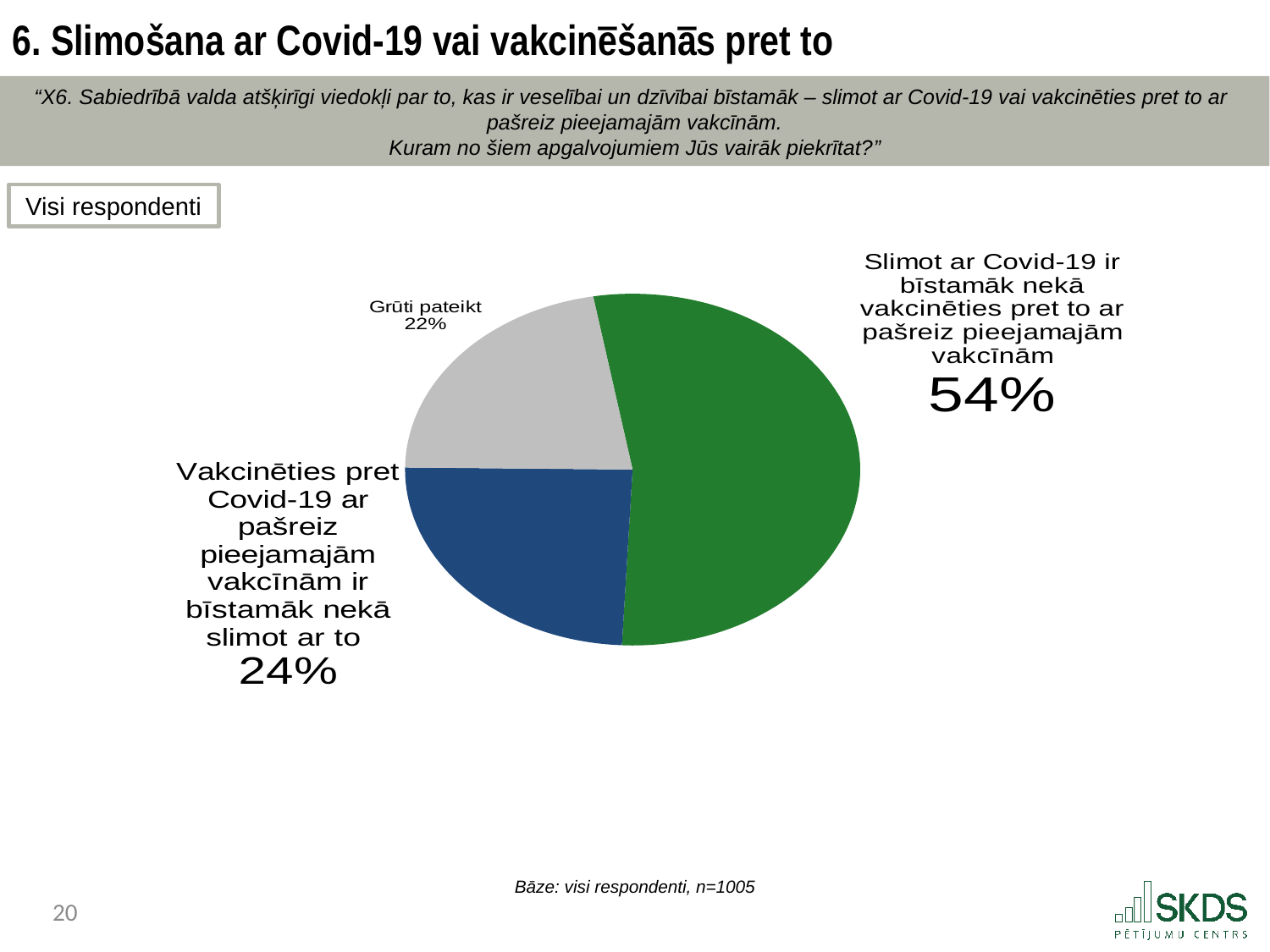
What share of respondents chose "Vakcinēties pret Covid-19 ar pašreiz pieejamajām vakcīnām ir bīstamāk nekā slimot ar to"? 24% What is the difference in percentage points between the "Slimot ar Covid-19 ir bīstamāk" slice and the "Vakcinēties ... ir bīstamāk" slice? 30 percentage points What kind of chart is shown on the slide? Pie chart Which answer option has the smallest share of the pie? Grūti pateikt How many slices does the pie chart have? 3 What colour is the slice representing "Grūti pateikt"? Grey What is the difference in percentage points between the "Vakcinēties ... ir bīstamāk nekā slimot ar to" slice and the "Grūti pateikt" slice? 2 percentage points What percentage of respondents answered "Grūti pateikt"? 22% What is the base (number of respondents) stated below the chart? n=1005 What share of respondents chose "Slimot ar Covid-19 ir bīstamāk nekā vakcinēties pret to ar pašreiz pieejamajām vakcīnām"? 54% Which answer option has the largest share of the pie? Slimot ar Covid-19 ir bīstamāk nekā vakcinēties pret to ar pašreiz pieejamajām vakcīnām Which is larger: the share for "Slimot ar Covid-19 ir bīstamāk" or the share for "Grūti pateikt"? Slimot ar Covid-19 ir bīstamāk